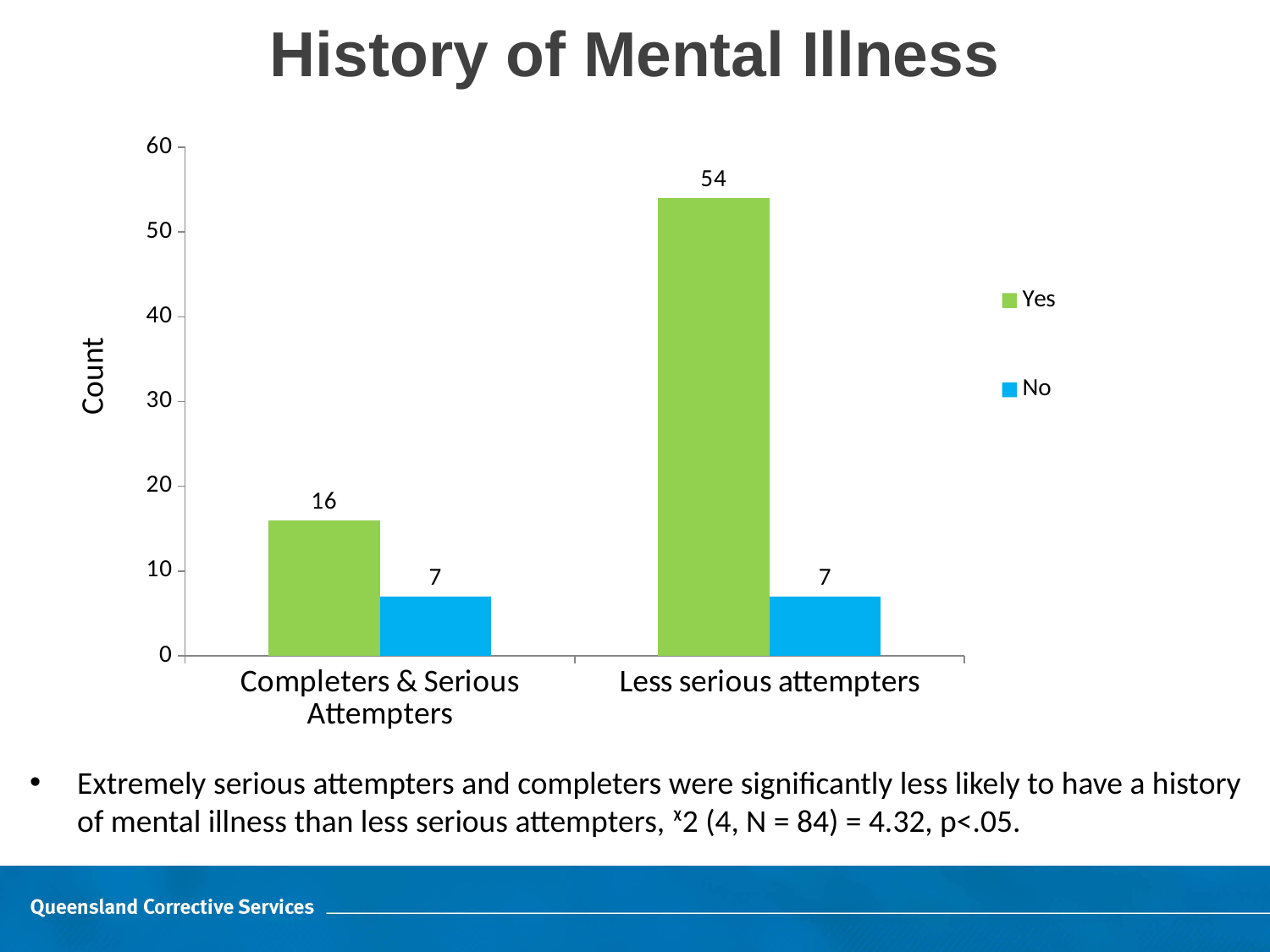
What is the difference between the 'Yes' and 'No' counts for Completers & Serious Attempters? 9 What is the 'Yes' count for Completers & Serious Attempters? 16 Which category has the highest 'Yes' count? Less serious attempters What is the difference between the 'Yes' counts for Less serious attempters and Completers & Serious Attempters? 38 What is the 'Yes' count for Less serious attempters? 54 What is the label of the y axis? Count How many series does the legend list? 2 What kind of chart is shown on the slide? Bar chart Which bar on the chart is the tallest? Yes for Less serious attempters What is the 'No' count for Less serious attempters? 7 How many categories are shown on the x axis? 2 Which is larger for Completers & Serious Attempters, the 'Yes' count or the 'No' count? Yes